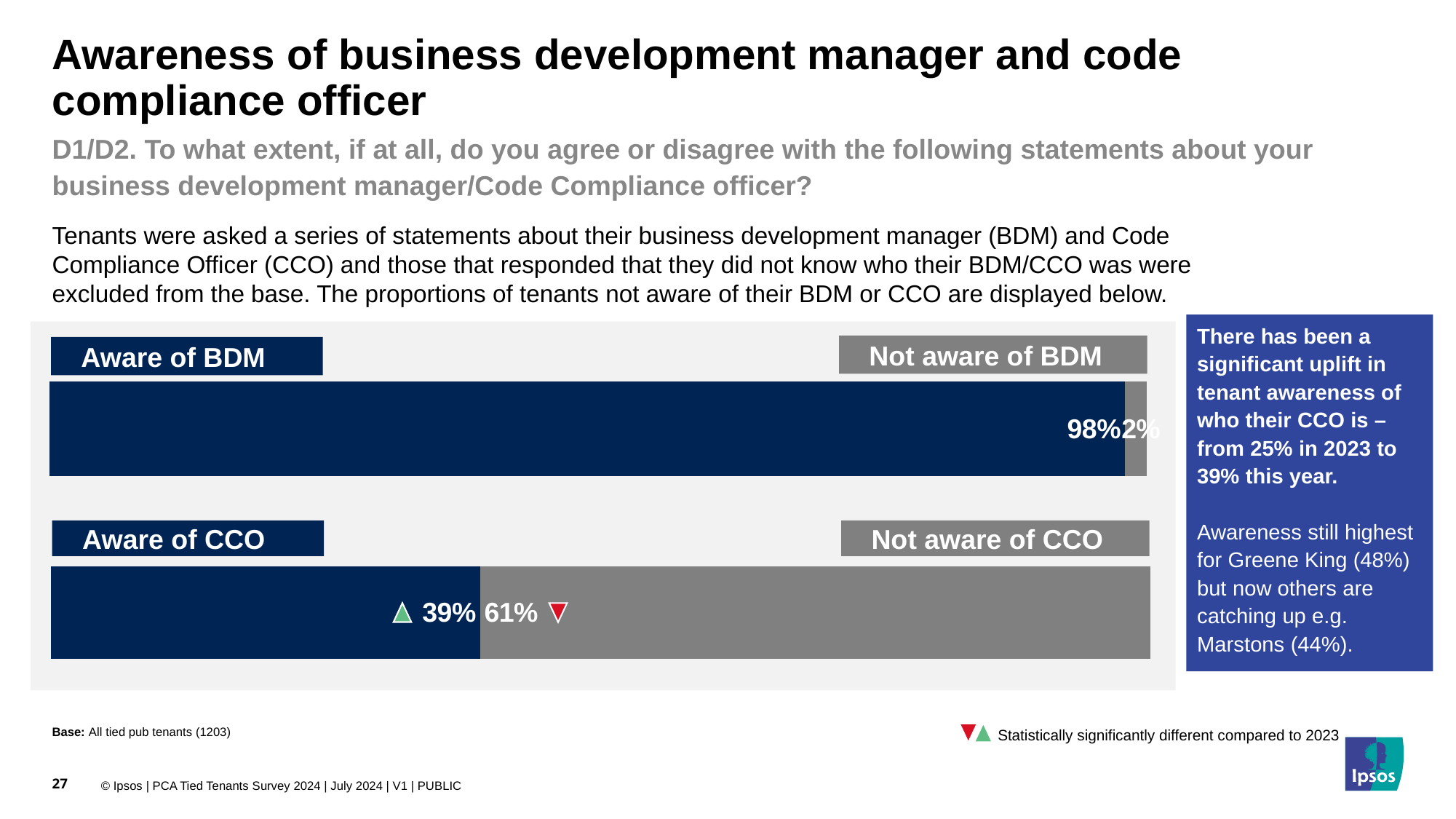
Which is larger: the share aware of their BDM or the share aware of their CCO? Aware of BDM Which segment of the CCO bar is marked with a green upward triangle? 39% (Aware of CCO) How many bars are shown in the chart? 2 What kind of chart is shown on the slide? Stacked bar chart What is the total of the two segments in the CCO bar? 100% What is the difference in percentage points between tenants aware of their BDM and tenants aware of their CCO? 59 What percentage of tenants are aware of their BDM? 98% What colour is used for the 'Not aware' segments of the bars? Grey What percentage of tenants are not aware of their BDM? 2% What is the difference in percentage points between tenants not aware of their CCO and tenants aware of their CCO? 22 What percentage of tenants are not aware of their CCO? 61% What percentage of tenants are aware of their CCO? 39%